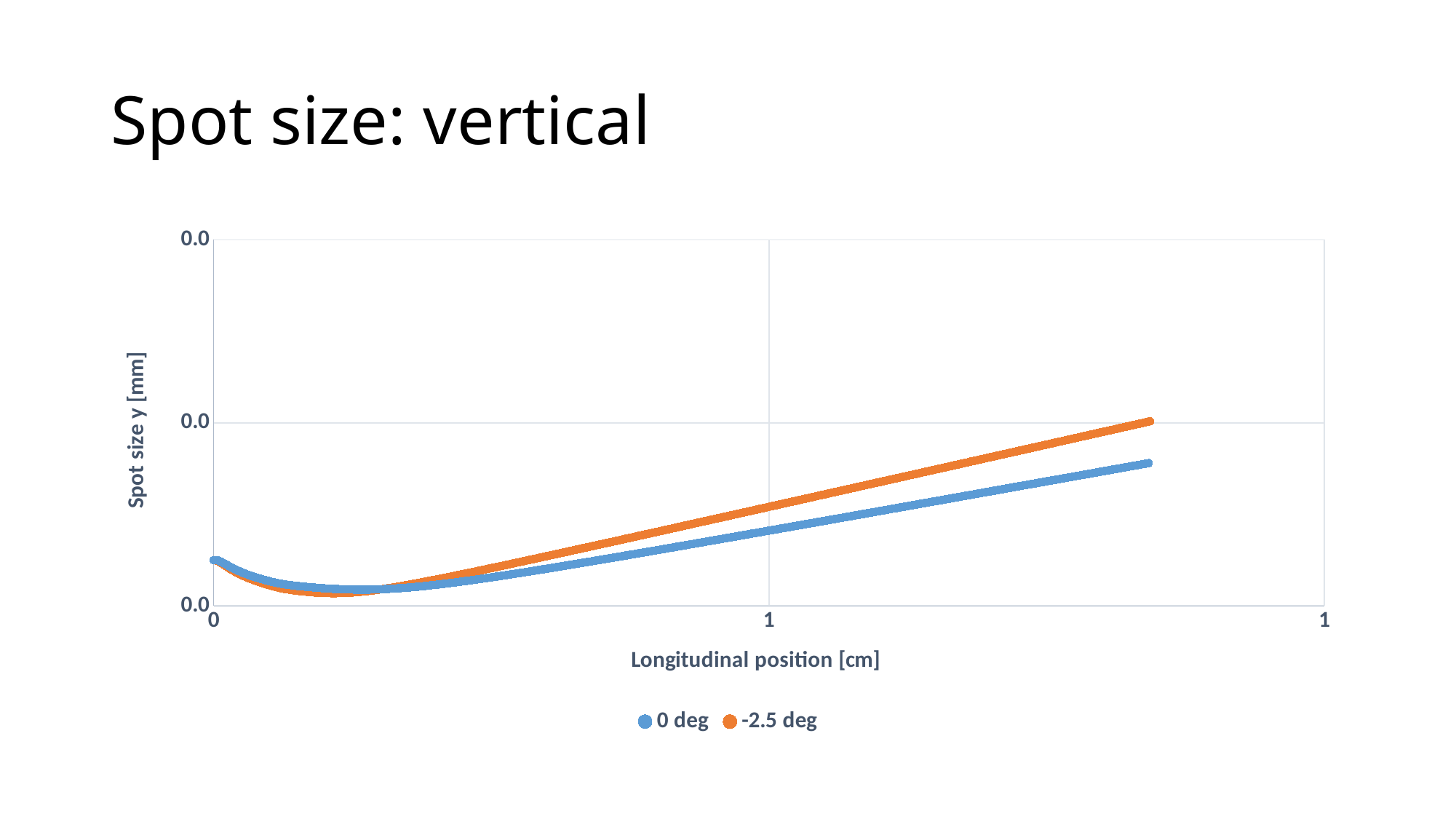
What are the two series named in the legend? 0 deg and -2.5 deg What is the label of the x axis? Longitudinal position [cm] How many series does the legend list? 2 Over the right half of the chart, do the spot size values rise or fall as longitudinal position increases? Rise At the right-hand end of the plotted lines, which series has the larger spot size, 0 deg or -2.5 deg? -2.5 deg Which series reaches the highest spot size value on the chart? -2.5 deg Near the minimum of the curves, which series dips lower, 0 deg or -2.5 deg? -2.5 deg What kind of chart is shown on the slide? Line chart